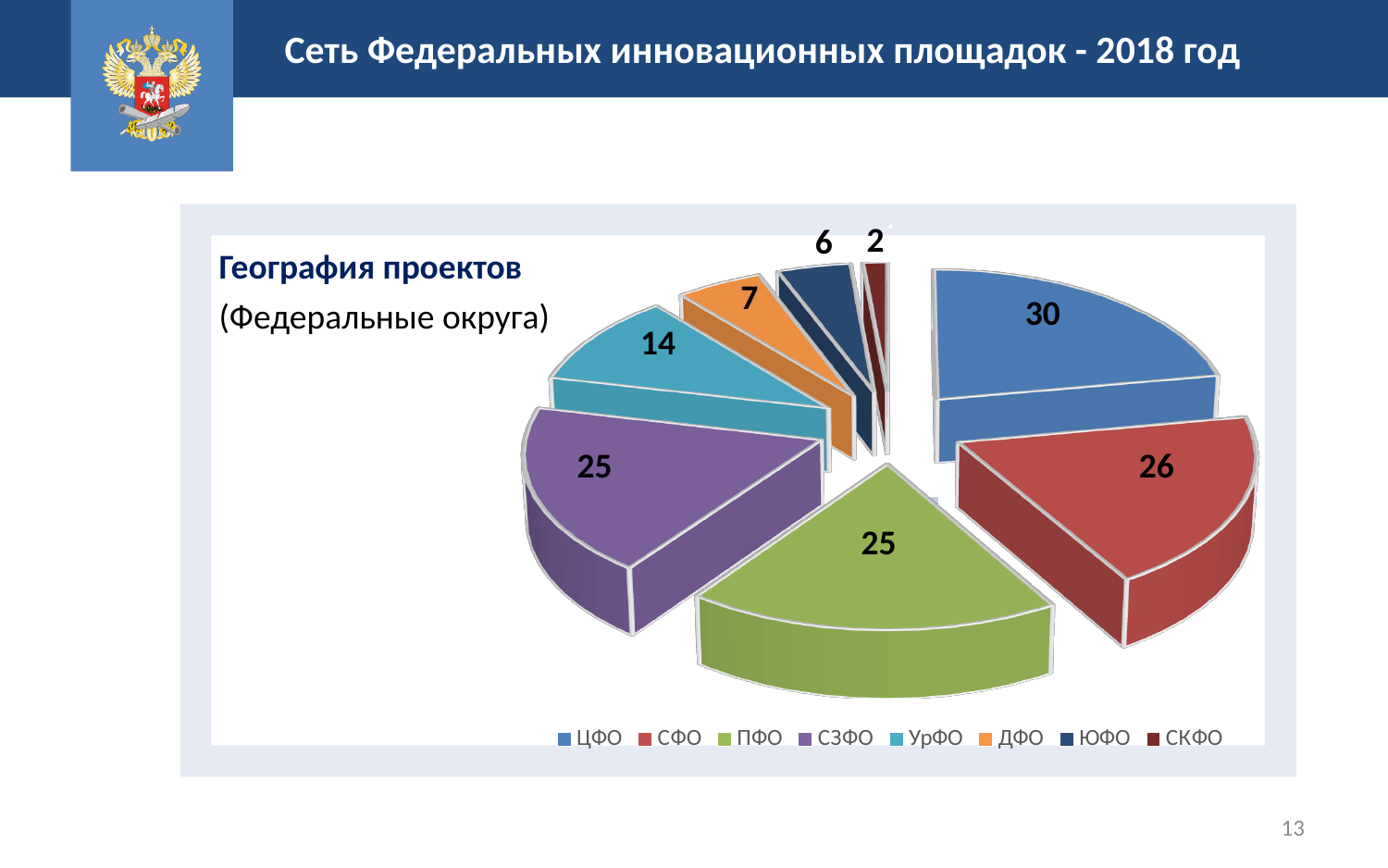
What is the value for УрФО in the pie chart? 14 What is the value for ЦФО in the pie chart? 30 Which is larger, the value for ДФО or the value for ЮФО? ДФО What is the difference between the values for ЦФО and СФО? 4 How many slices does the pie chart have? 8 Which federal district has the smallest slice in the pie chart? СКФО What kind of chart is shown on the slide? pie chart What colour is the slice for ПФО in the pie chart? green What is the value for СКФО in the pie chart? 2 What is the value for СФО in the pie chart? 26 Which federal district has the largest slice in the pie chart? ЦФО What is the total of all the values shown in the pie chart? 135